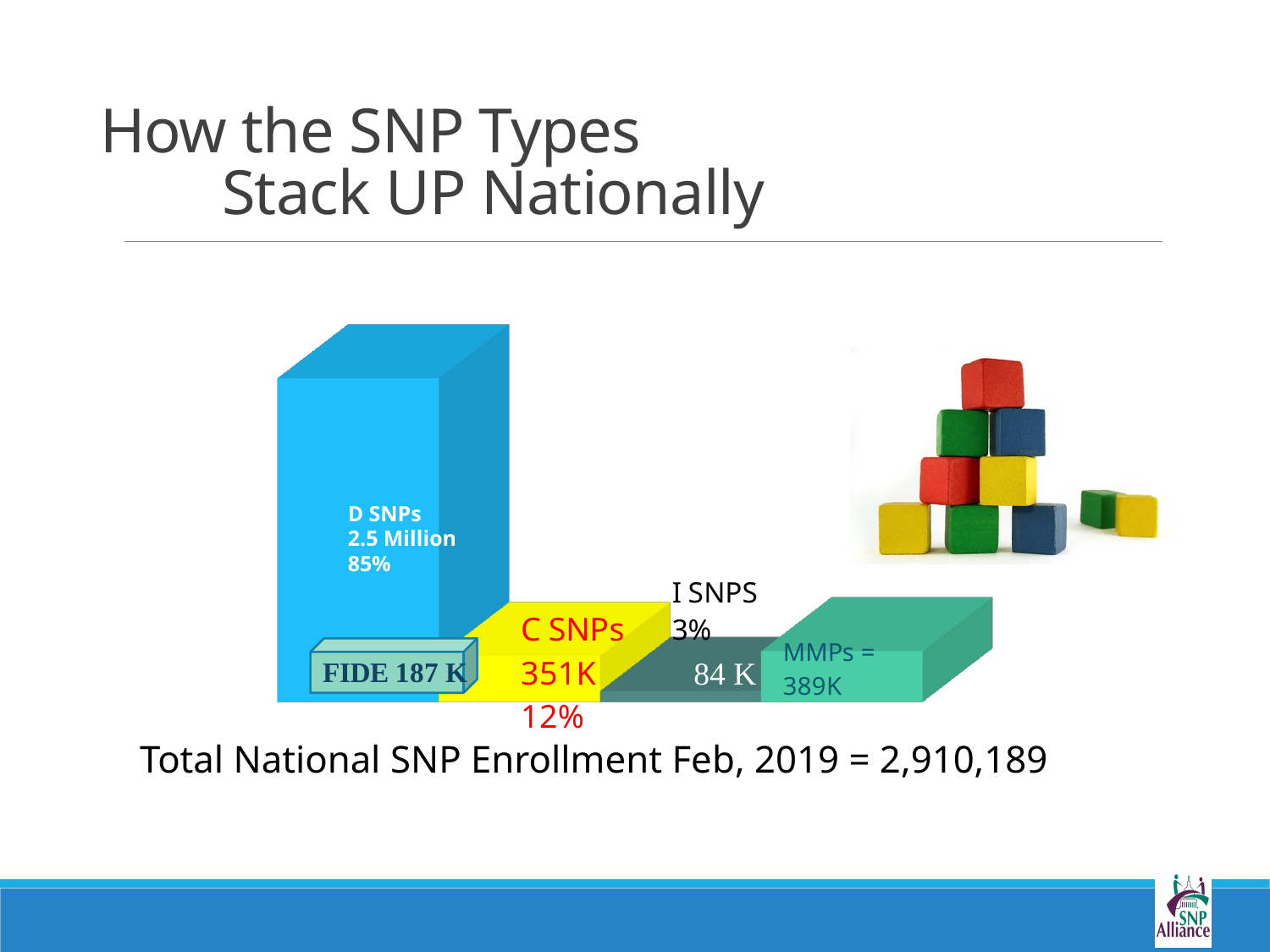
What is the enrollment value shown for FIDE? 187 K What percentage is shown for D SNPs? 85% Which SNP type has the highest enrollment? D SNPs What percentage is shown for C SNPs? 12% What is the enrollment value shown for MMPs? 389K Which has higher enrollment, C SNPs or MMPs? MMPs What kind of chart is shown on the slide? Bar chart What is the enrollment value shown for C SNPs? 351K What is the total national SNP enrollment for Feb 2019 stated on the slide? 2,910,189 What is the enrollment value shown for I SNPs? 84 K What is the enrollment value shown for D SNPs? 2.5 Million Which SNP type has the lowest enrollment? I SNPs